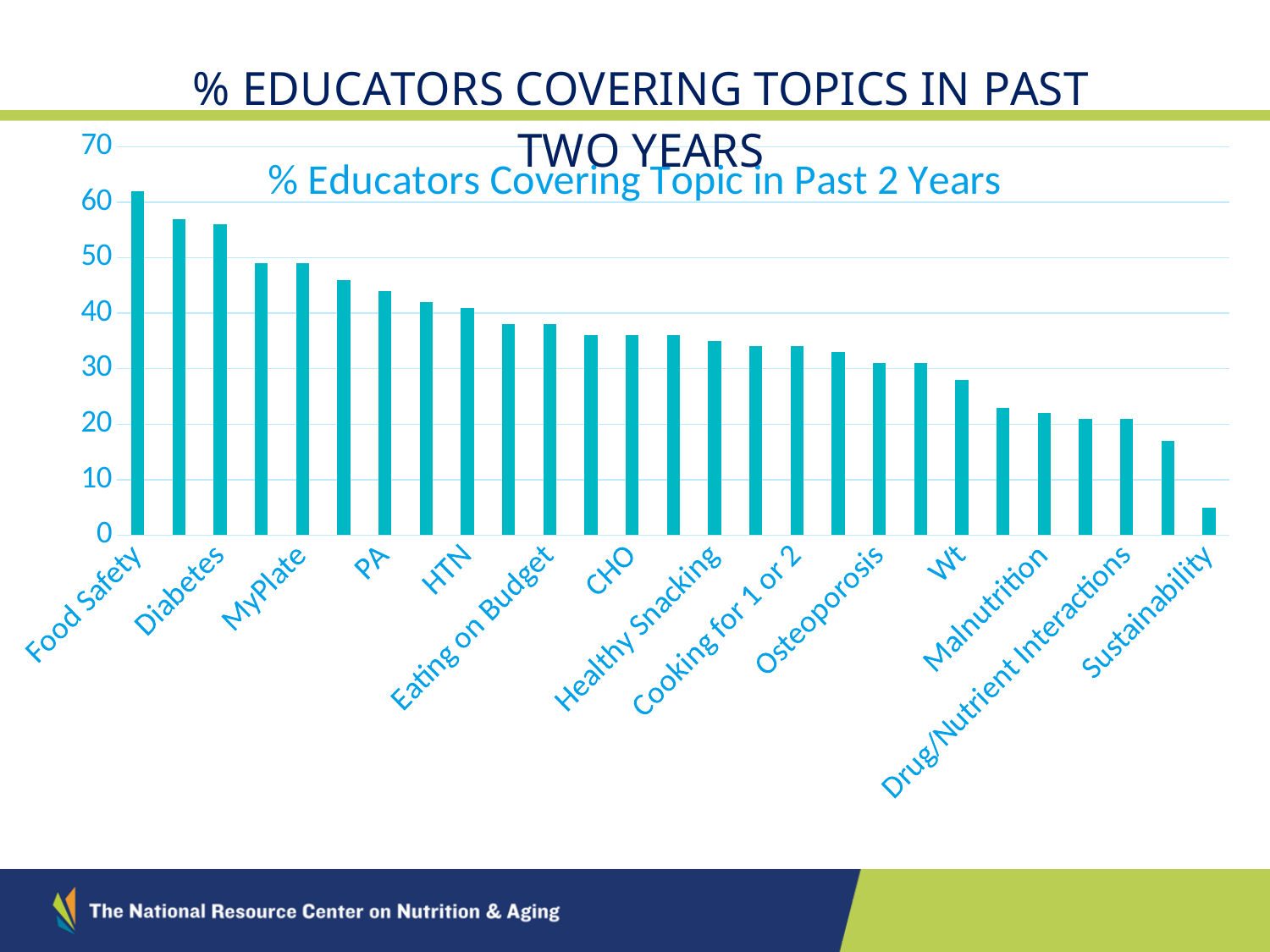
Is the value for Food Safety greater or less than 50? greater Is the value for Drug/Nutrient Interactions greater or less than 30? less Is the value for Osteoporosis greater or less than 40? less What kind of chart is shown on the slide? Bar chart Which topic has the lowest percentage of educators covering it? Sustainability Which topic has the highest percentage of educators covering it? Food Safety Which has a higher value, Diabetes or Malnutrition? Diabetes Do the bar values rise or fall from left to right across the chart? Fall